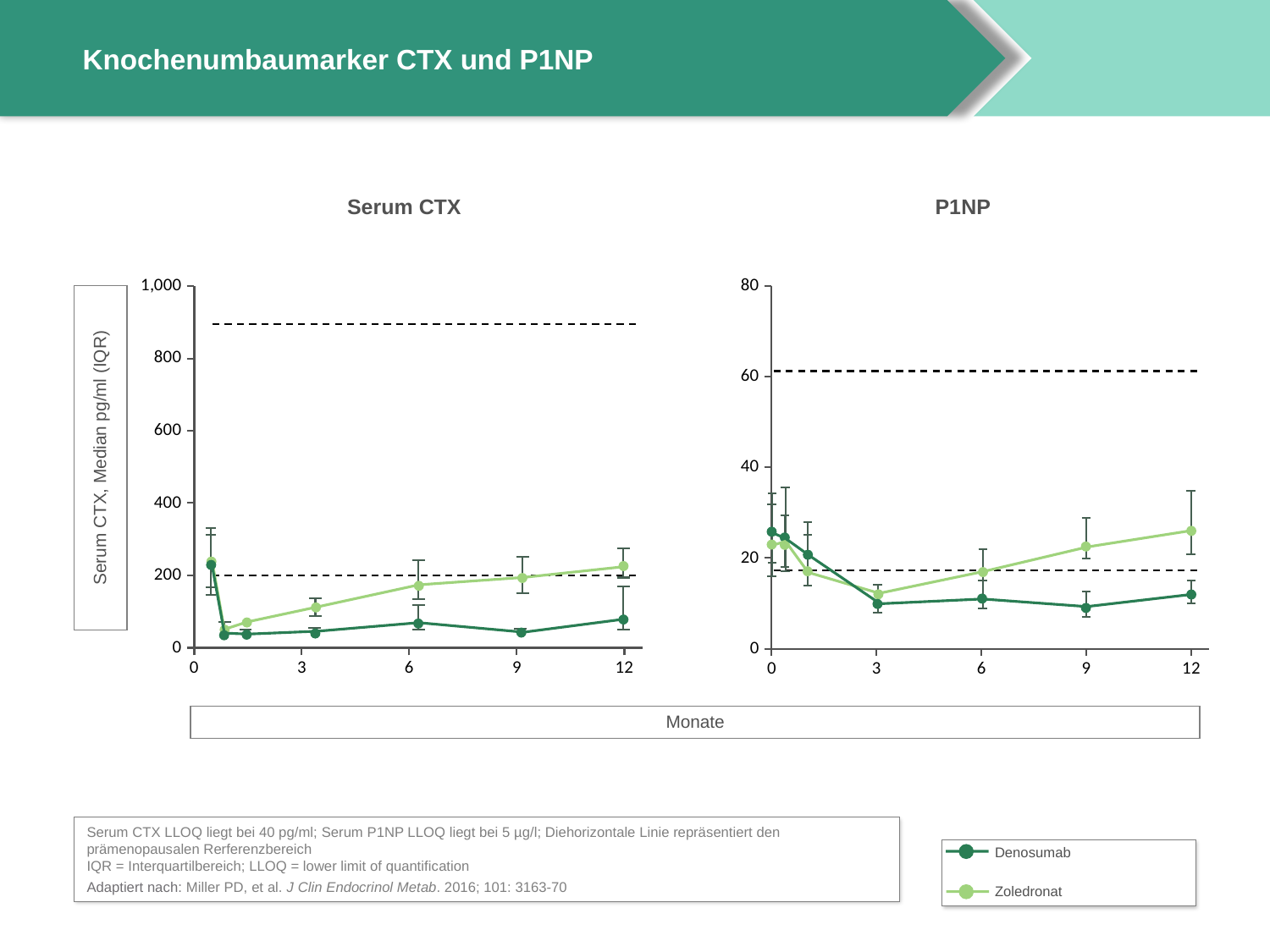
What is the x-axis label shared by both charts? Monate In the P1NP chart, is the Denosumab value at 3 months greater or less than 20? less How many series does the legend list? 2 In the Serum CTX chart, is the Denosumab value at 12 months greater or less than 200? less In the P1NP chart, is the Zoledronat value at 12 months greater or less than 20? greater In the Serum CTX chart, which series has the larger value at 6 months, Denosumab or Zoledronat? Zoledronat In the Serum CTX chart, does the Zoledronat series rise or fall between 3 and 12 months? rise What are the two series named in the legend? Denosumab and Zoledronat In the P1NP chart, does the Denosumab series rise or fall between 0 and 3 months? fall What kind of chart is the Serum CTX chart? line chart In the P1NP chart, which series has the larger value at 12 months, Denosumab or Zoledronat? Zoledronat